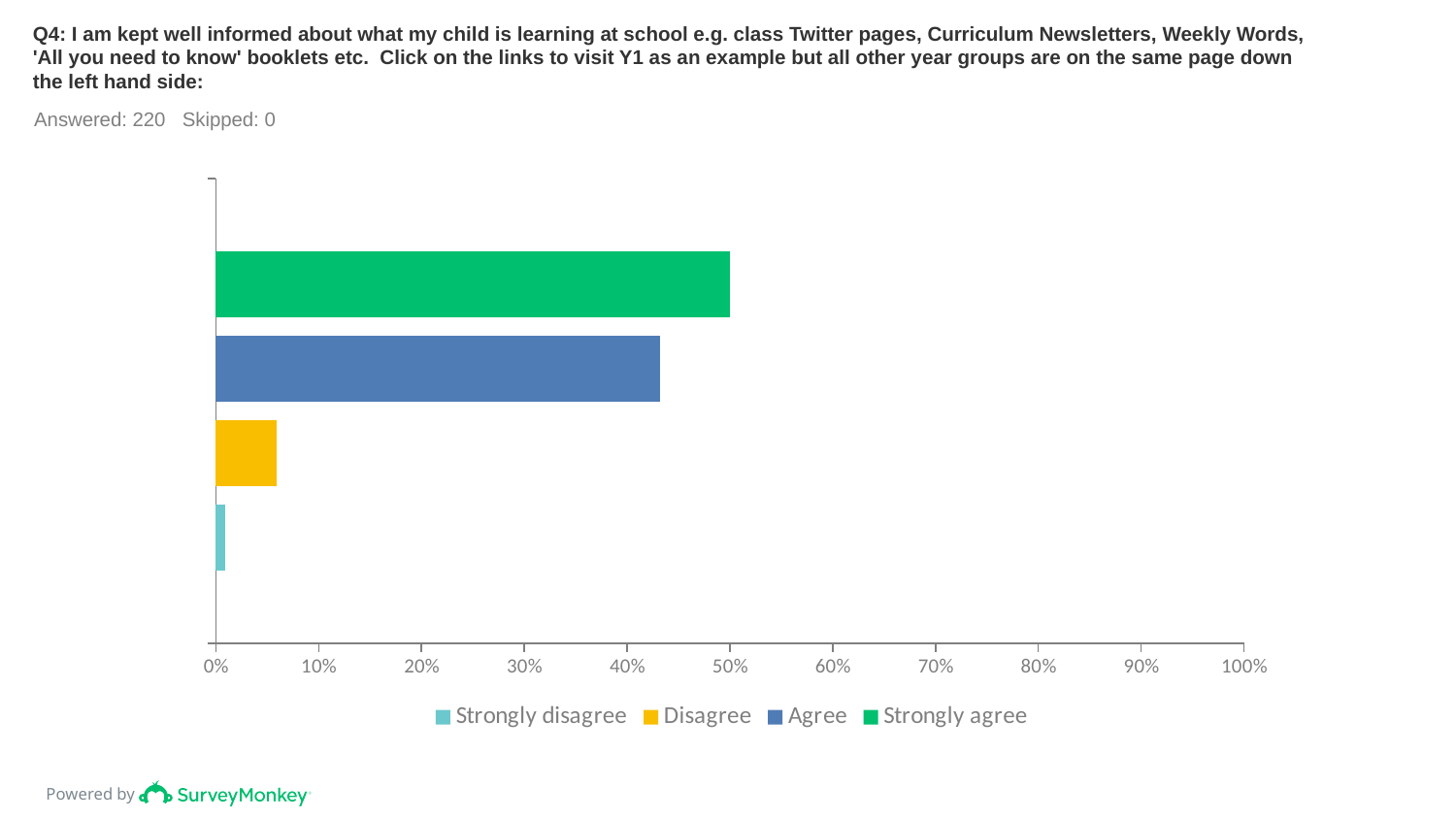
Which is larger, the value for Agree or the value for Disagree? Agree What kind of chart is shown on the slide? bar chart How many respondents answered this question according to the slide? 220 Is the value for Strongly agree greater or less than 40%? greater What colour is the bar for Strongly agree? green How many bars are plotted in the chart? 4 Which response category has the highest value? Strongly agree Is the value for Agree greater or less than 40%? greater Is the value for Disagree greater or less than 10%? less Which response category has the lowest value? Strongly disagree How many series does the legend list? 4